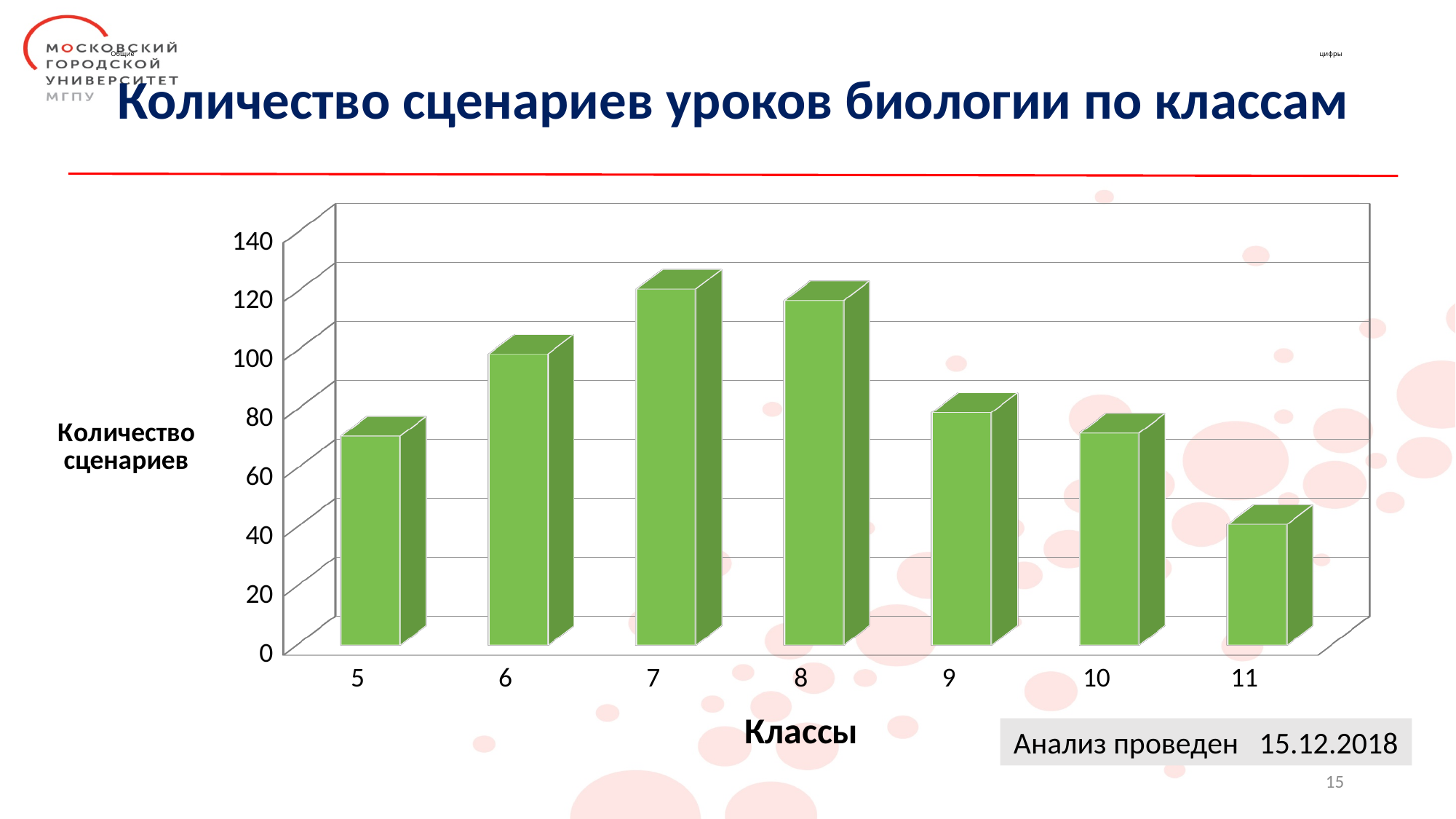
How many classes (categories) are shown on the x axis? 7 Is the value for class 5 greater or less than 80? less What kind of chart is shown on the slide? Bar chart Is the value for class 10 greater or less than 100? less Which has more lesson scenarios, class 6 or class 9? Class 6 Which class has the highest number of lesson scenarios? 7 Is the value for class 11 greater or less than 60? less Which class has the lowest number of lesson scenarios? 11 What is the label of the x axis? Классы Do the values rise or fall from class 8 to class 11? Fall